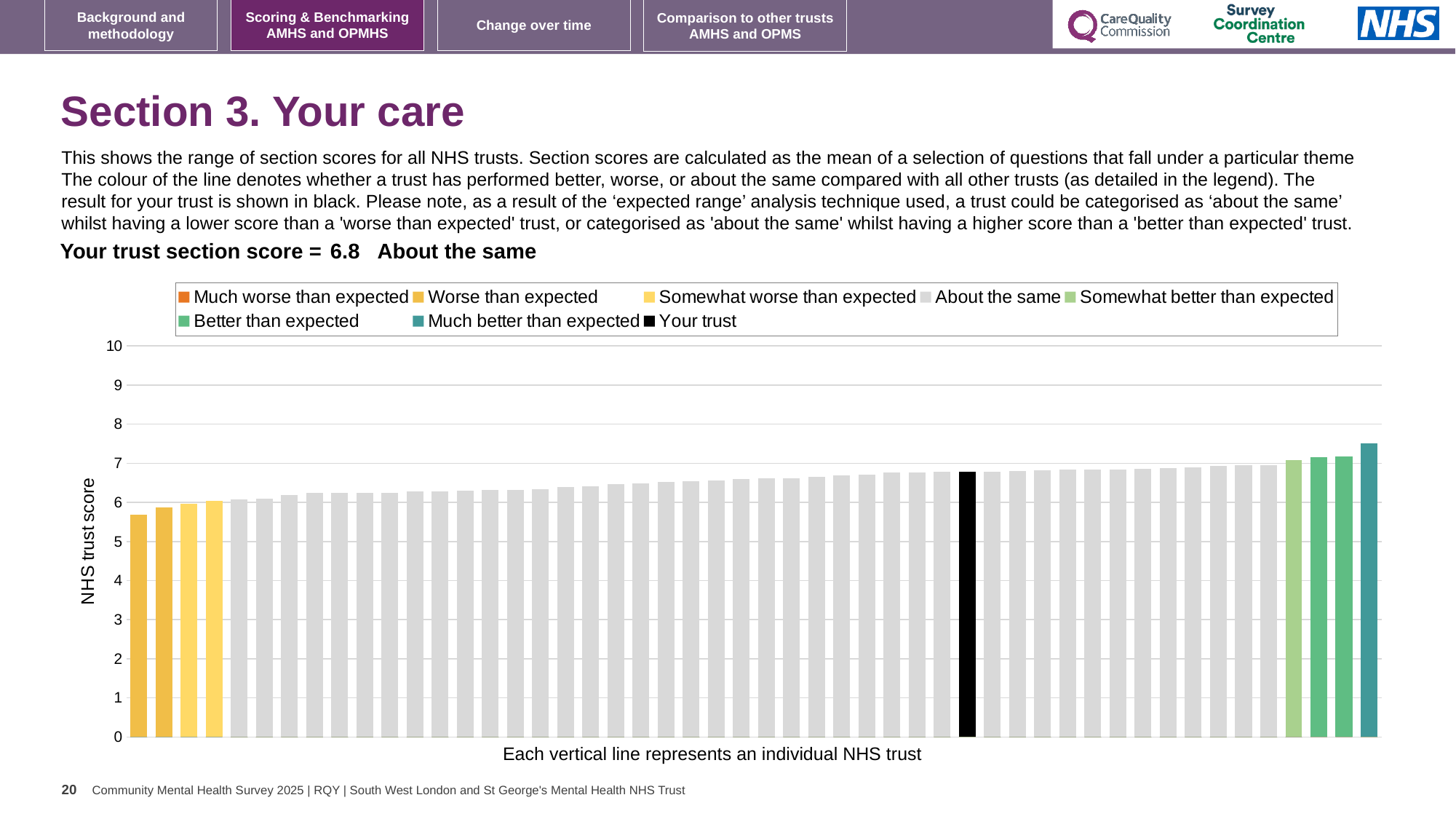
Which legend category does your trust fall into? About the same Is your trust's section score greater or less than 7? less Is the value of the tallest bar (rightmost) greater or less than 7? greater What is your trust's section score for Section 3. Your care? 6.8 Is the rightmost bar higher or lower than your trust's bar? higher Do the bar values rise or fall from left to right along the x axis? rise What kind of chart is shown on the slide? Bar chart Is the value of the shortest bar (leftmost) greater or less than 6? less How many entries does the chart legend list? 8 What is the label on the vertical axis of the chart? NHS trust score Which legend category does the lowest-scoring trust belong to? Worse than expected Which legend category does the highest-scoring trust belong to? Much better than expected